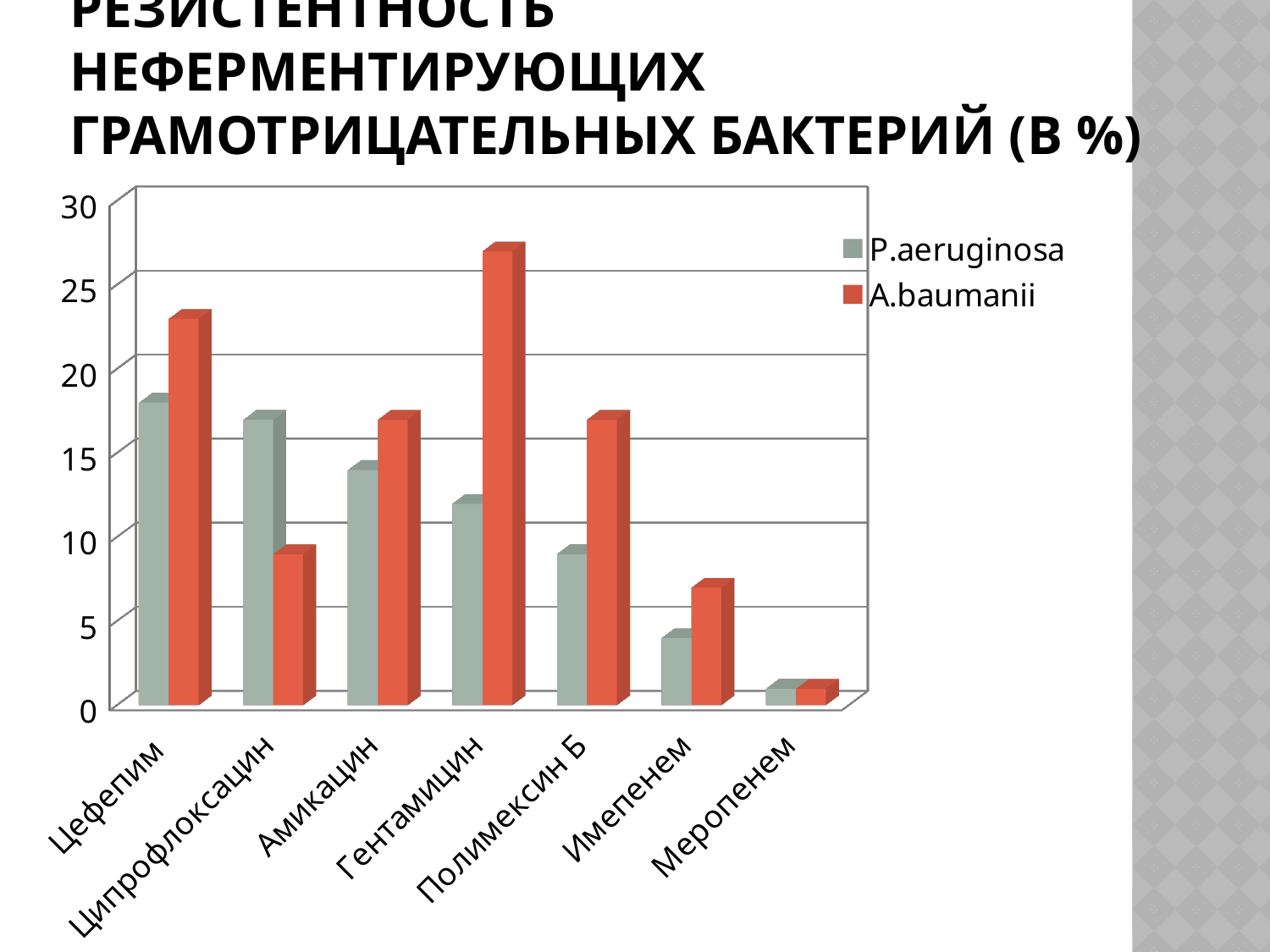
For which antibiotic is the P.aeruginosa resistance lowest? Меропенем How many antibiotic categories are shown on the x axis? 7 Is the A.baumanii value for Ципрофлоксацин greater or less than 10? less For which antibiotic is the A.baumanii resistance lowest? Меропенем What kind of chart is shown on the slide? bar chart How many series does the legend list? 2 Which series is shown in red in the legend? A.baumanii For Ципрофлоксацин, which series has the larger value, P.aeruginosa or A.baumanii? P.aeruginosa Is the P.aeruginosa value for Цефепим greater or less than 20? less Is the A.baumanii value for Гентамицин greater or less than 25? greater For Цефепим, which series has the larger value, P.aeruginosa or A.baumanii? A.baumanii For which antibiotic is the A.baumanii resistance highest? Гентамицин